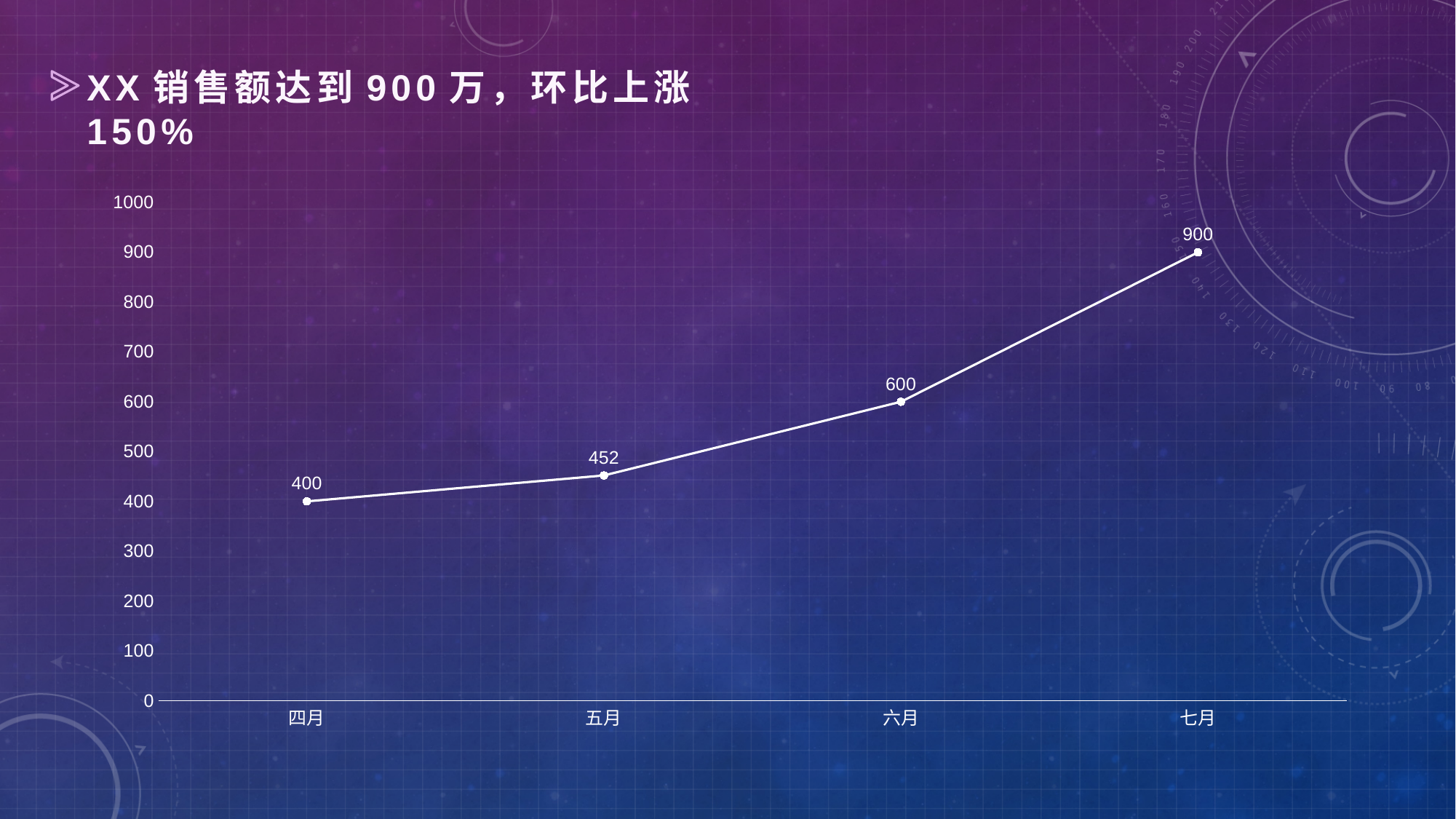
What is the value for 七月? 900 What is the difference between the values for 五月 and 四月? 52 What is the value for 五月? 452 Do the values rise or fall from 四月 to 七月? Rise What kind of chart is shown on the slide? Line chart Which month has the lowest value? 四月 What is the difference between the values for 七月 and 六月? 300 What is the value for 六月? 600 What is the value for 四月? 400 Which is larger, the value for 六月 or the value for 五月? 六月 Which month has the highest value? 七月 How many data points are plotted on the chart? 4